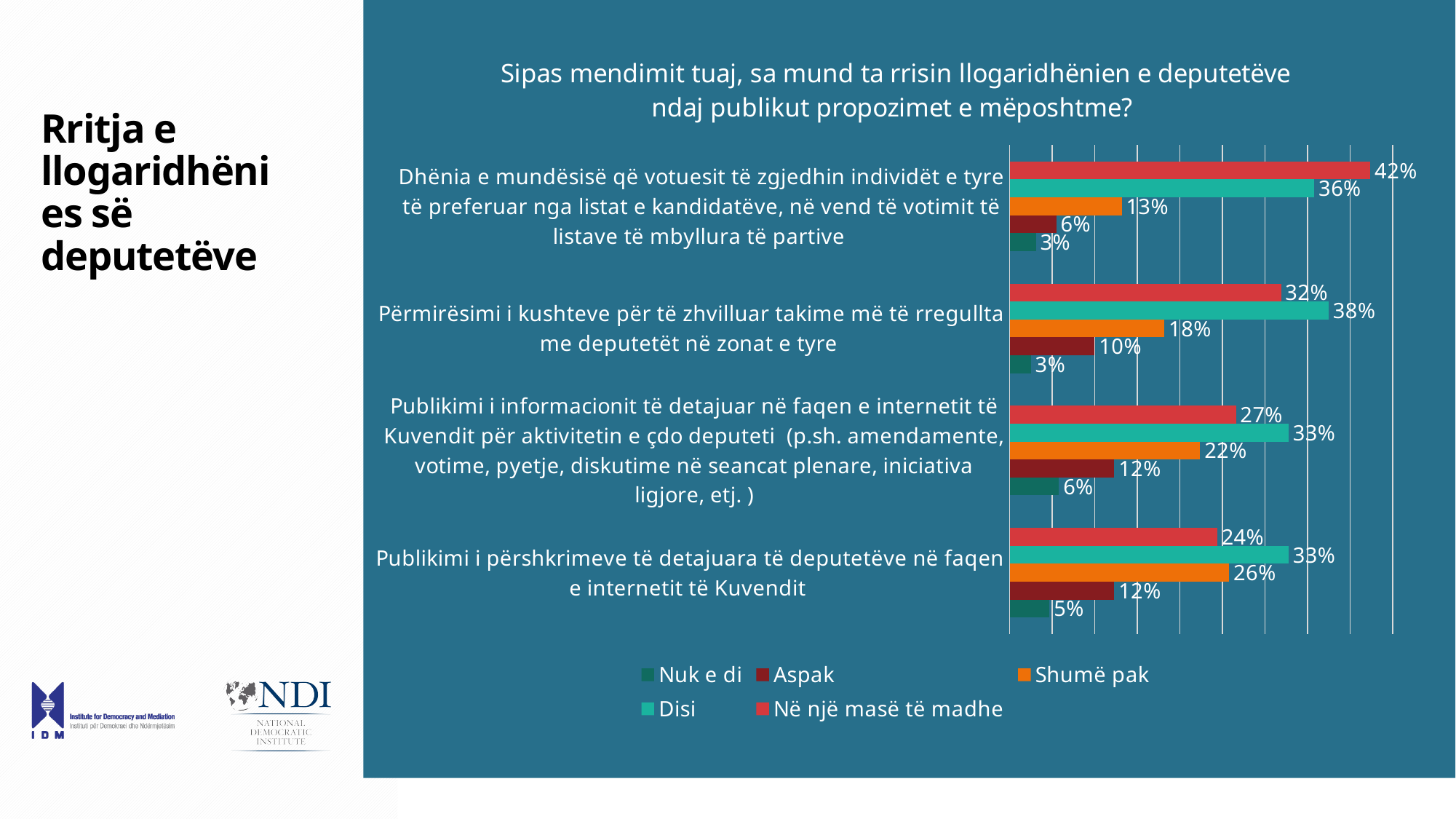
What type of chart is shown on the slide? bar chart How many series does the legend list? 5 How many proposals (categories) are shown in the chart? 4 What is the value of 'Disi' for 'Përmirësimi i kushteve për të zhvilluar takime më të rregullta me deputetët në zonat e tyre'? 38% Which proposal has the highest 'Në një masë të madhe' value? Dhënia e mundësisë që votuesit të zgjedhin individët e tyre të preferuar nga listat e kandidatëve, në vend të votimit të listave të mbyllura të partive What is the value of 'Në një masë të madhe' for 'Dhënia e mundësisë që votuesit të zgjedhin individët e tyre të preferuar nga listat e kandidatëve'? 42% What is the value of 'Shumë pak' for 'Publikimi i përshkrimeve të detajuara të deputetëve në faqen e internetit të Kuvendit'? 26% For 'Përmirësimi i kushteve për të zhvilluar takime më të rregullta me deputetët në zonat e tyre', which is larger: 'Disi' or 'Në një masë të madhe'? Disi Which proposal has the lowest 'Në një masë të madhe' value? Publikimi i përshkrimeve të detajuara të deputetëve në faqen e internetit të Kuvendit What is the difference between the 'Në një masë të madhe' values for 'Dhënia e mundësisë...' (42%) and 'Përmirësimi i kushteve...' (32%)? 10% What is the value of 'Aspak' for 'Publikimi i informacionit të detajuar në faqen e internetit të Kuvendit për aktivitetin e çdo deputeti'? 12% Which legend entry is shown in orange? Shumë pak